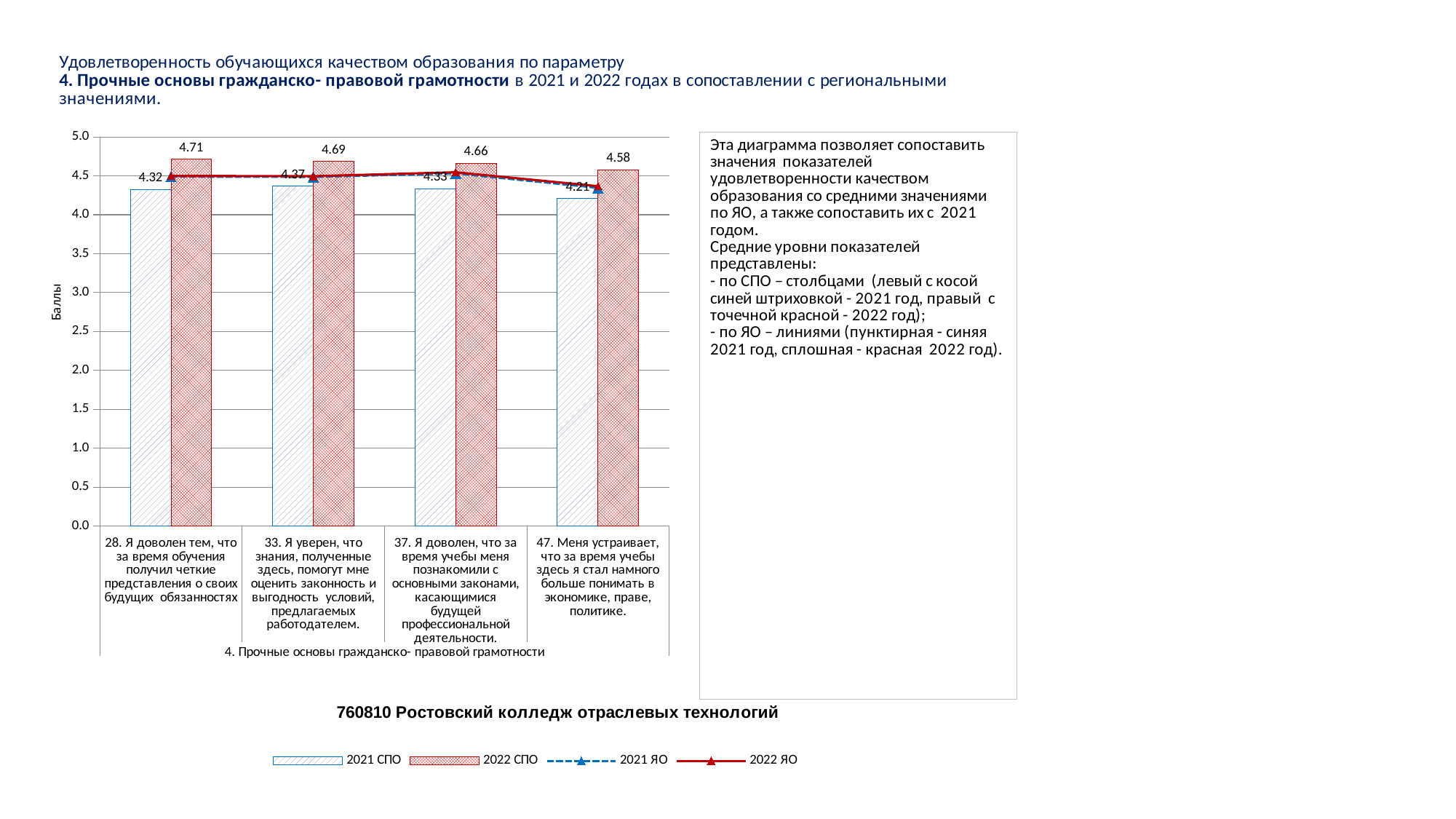
What is the value of the 2021 СПО bar for category 33 ("Я уверен, что знания, полученные здесь, помогут мне оценить законность и выгодность условий, предлагаемых работодателем")? 4.37 How many categories are shown on the x axis of the chart? 4 For category 33, which is larger: the 2021 СПО bar or the 2022 СПО bar? 2022 СПО Is the 2021 СПО value for category 28 greater or less than 4.5? less What is the value of the 2022 СПО bar for category 28 ("Я доволен тем, что за время обучения получил четкие представления о своих будущих обязанностях")? 4.71 What is the value of the 2022 СПО bar for category 37 ("Я доволен, что за время учебы меня познакомили с основными законами, касающимися будущей профессиональной деятельности")? 4.66 Which category has the lowest 2021 СПО value? 47. Меня устраивает, что за время учебы здесь я стал намного больше понимать в экономике, праве, политике How many series does the chart legend list? 4 Which category has the highest 2022 СПО value? 28. Я доволен тем, что за время обучения получил четкие представления о своих будущих обязанностях What is the label of the vertical axis of the chart? Баллы What is the difference between the 2022 СПО and 2021 СПО values for category 47? 0.37 What is the value of the 2021 СПО bar for category 47 ("Меня устраивает, что за время учебы здесь я стал намного больше понимать в экономике, праве, политике")? 4.21